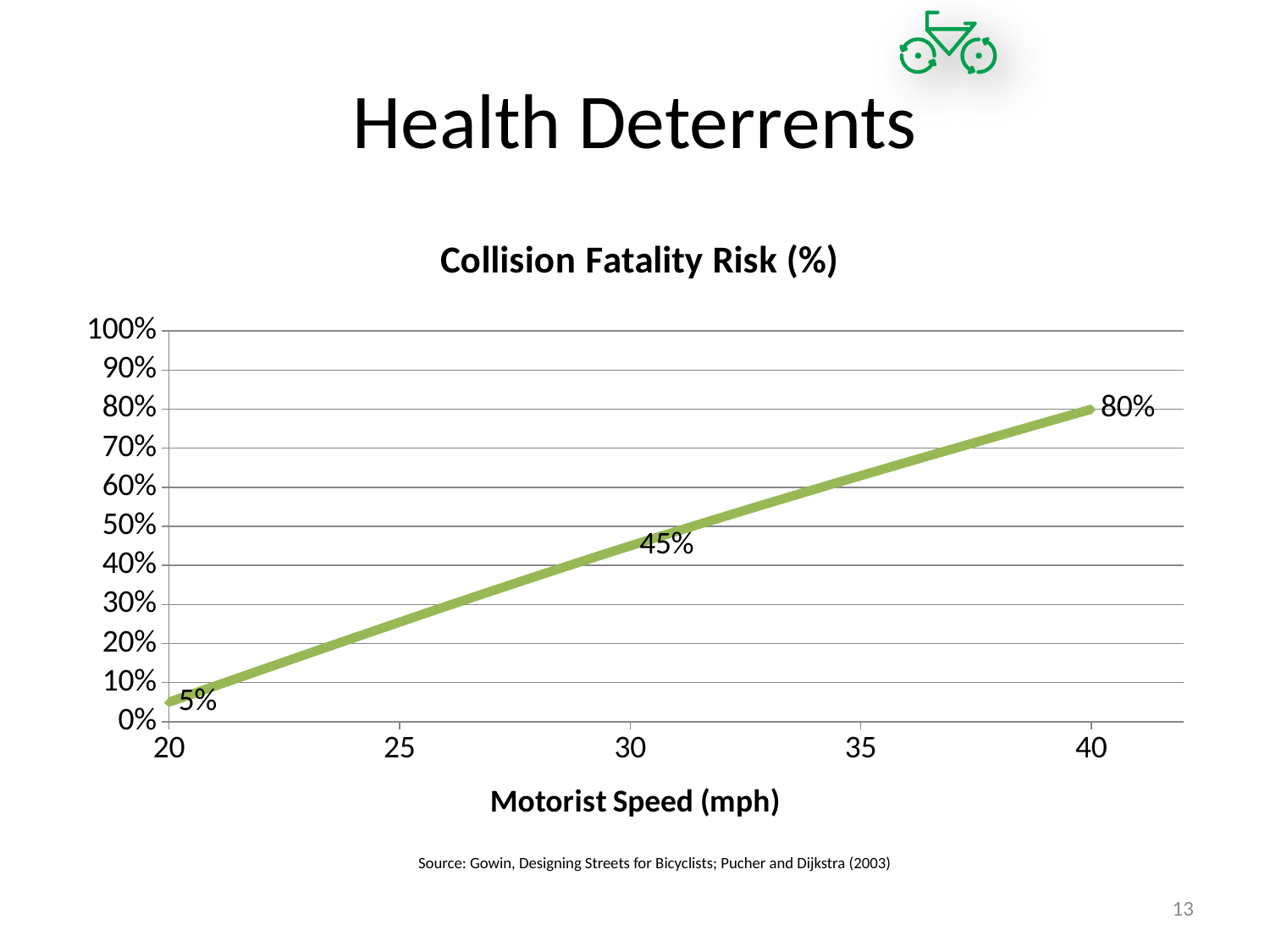
At which motorist speed is the collision fatality risk highest? 40 mph Does the collision fatality risk rise or fall as motorist speed increases? Rises What kind of chart is shown on the slide? Line chart What is the difference in collision fatality risk between 40 mph and 30 mph? 35% What is the collision fatality risk at a motorist speed of 20 mph? 5% Is the collision fatality risk at 35 mph greater or less than 50%? greater What is the collision fatality risk at a motorist speed of 40 mph? 80% What is the collision fatality risk at a motorist speed of 30 mph? 45% Which has a higher collision fatality risk, 30 mph or 40 mph? 40 mph What is the difference in collision fatality risk between 30 mph and 20 mph? 40% How many data points are labeled with values on the chart? 3 At which motorist speed is the collision fatality risk lowest? 20 mph